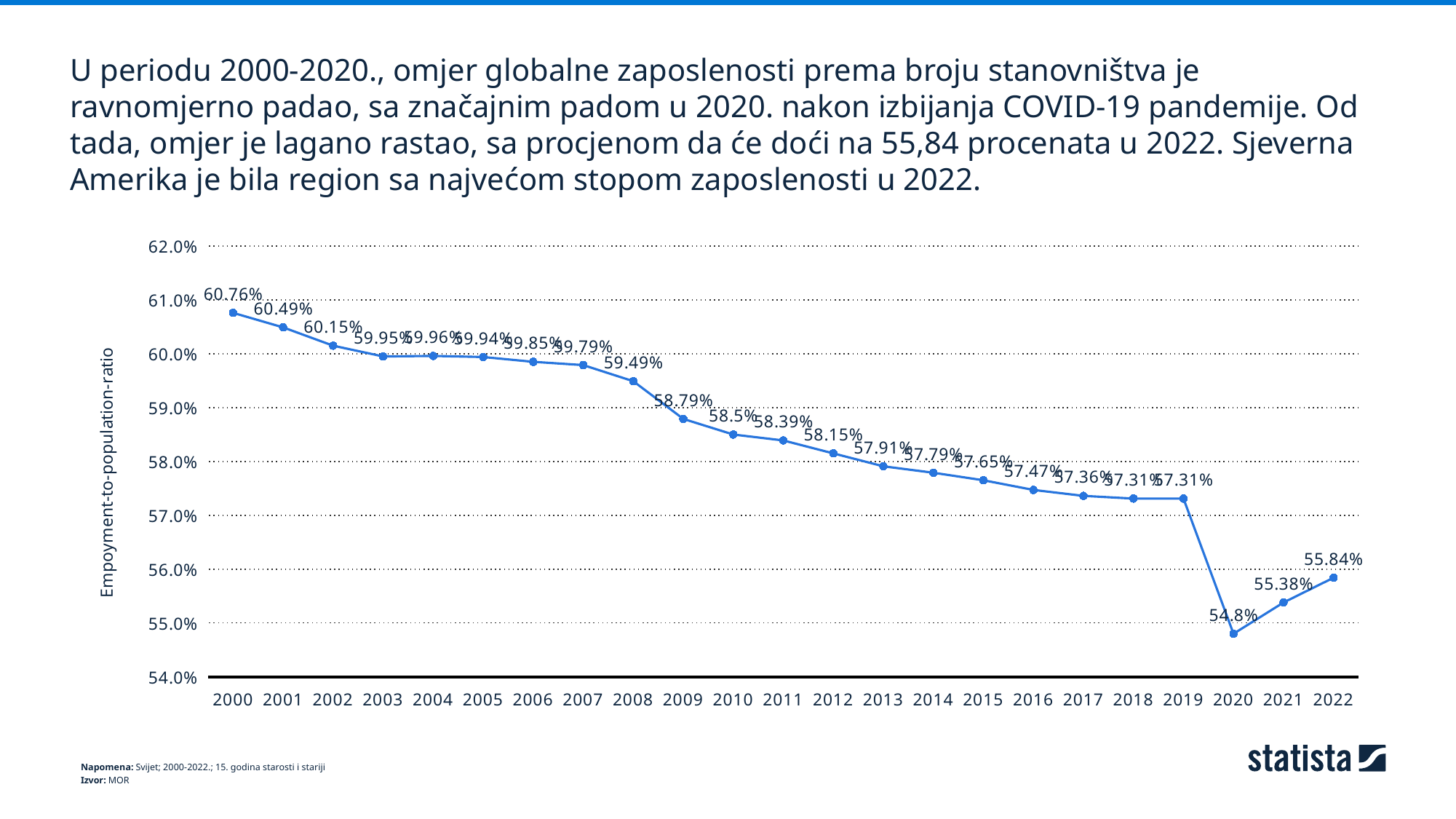
How many years are plotted on the chart? 23 What is the value shown for 2008? 59.49% Is the value for 2009 greater or less than 59.0%? less What is the employment-to-population ratio shown for 2000? 60.76% What is the difference between the values for 2019 and 2020? 2.51% Which year has the lowest employment-to-population ratio on the chart? 2020 Which year has the highest employment-to-population ratio on the chart? 2000 What is the label on the vertical axis of the chart? Empoyment-to-population-ratio Which is larger, the value for 2021 or the value for 2022? 2022 What value is plotted for 2020? 54.8% What is the value shown for 2022? 55.84% What kind of chart is shown on the slide? line chart